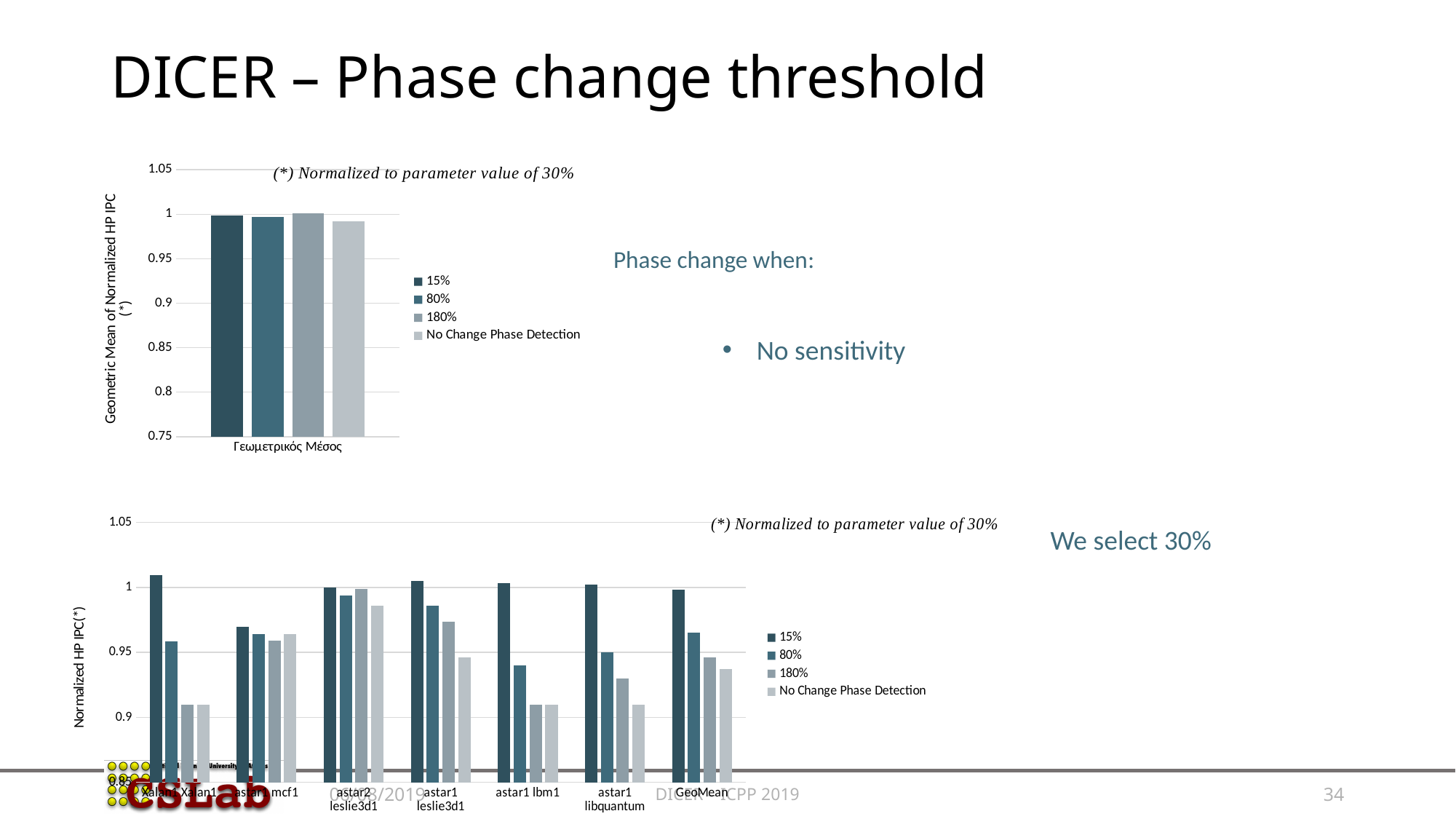
What is the last legend entry of the bottom chart? No Change Phase Detection In the bottom chart, is the 15% value for Xalan1 Xalan1 greater or less than 1? greater In the top chart, is the value for the 15% series greater or less than 0.95? greater How many categories are shown on the x axis of the bottom chart? 7 What is the y-axis title of the top chart? Geometric Mean of Normalized HP IPC (*) In the bottom chart, is the 180% value for Xalan1 Xalan1 greater or less than 0.95? less How many series does the legend of the top chart list? 4 In the bottom chart, which series has the highest value for astar1 libquantum? 15% What type of chart is the top chart on the slide? bar chart How many categories are shown on the x axis of the top chart? 1 In the bottom chart, for astar1 lbm1, which is larger: the 80% value or the 180% value? 80%